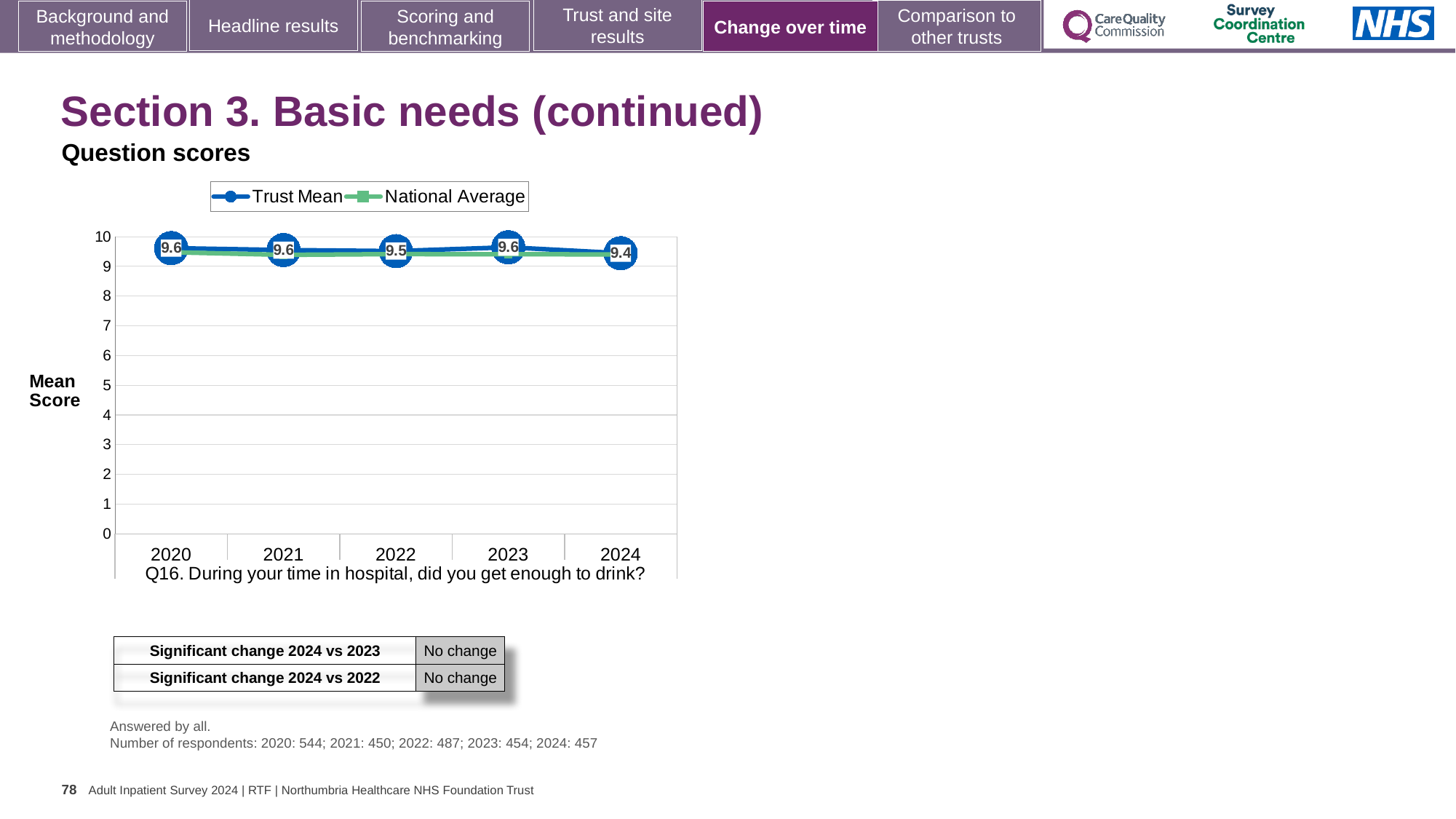
In which year is the Trust Mean score lowest? 2024 What is the Trust Mean score for 2022? 9.5 Which survey question does the chart show scores for? Q16. During your time in hospital, did you get enough to drink? What is the Trust Mean score for 2024? 9.4 What kind of chart is shown on the slide? line chart Does the Trust Mean score rise or fall from 2023 to 2024? fall What is the Trust Mean score for 2020? 9.6 Is the National Average value for 2024 greater or less than 9? greater Which is larger, the Trust Mean score for 2023 or for 2024? 2023 What is the difference between the Trust Mean score in 2020 and in 2024? 0.2 How many years are shown on the x axis of the chart? 5 How many series does the legend list? 2